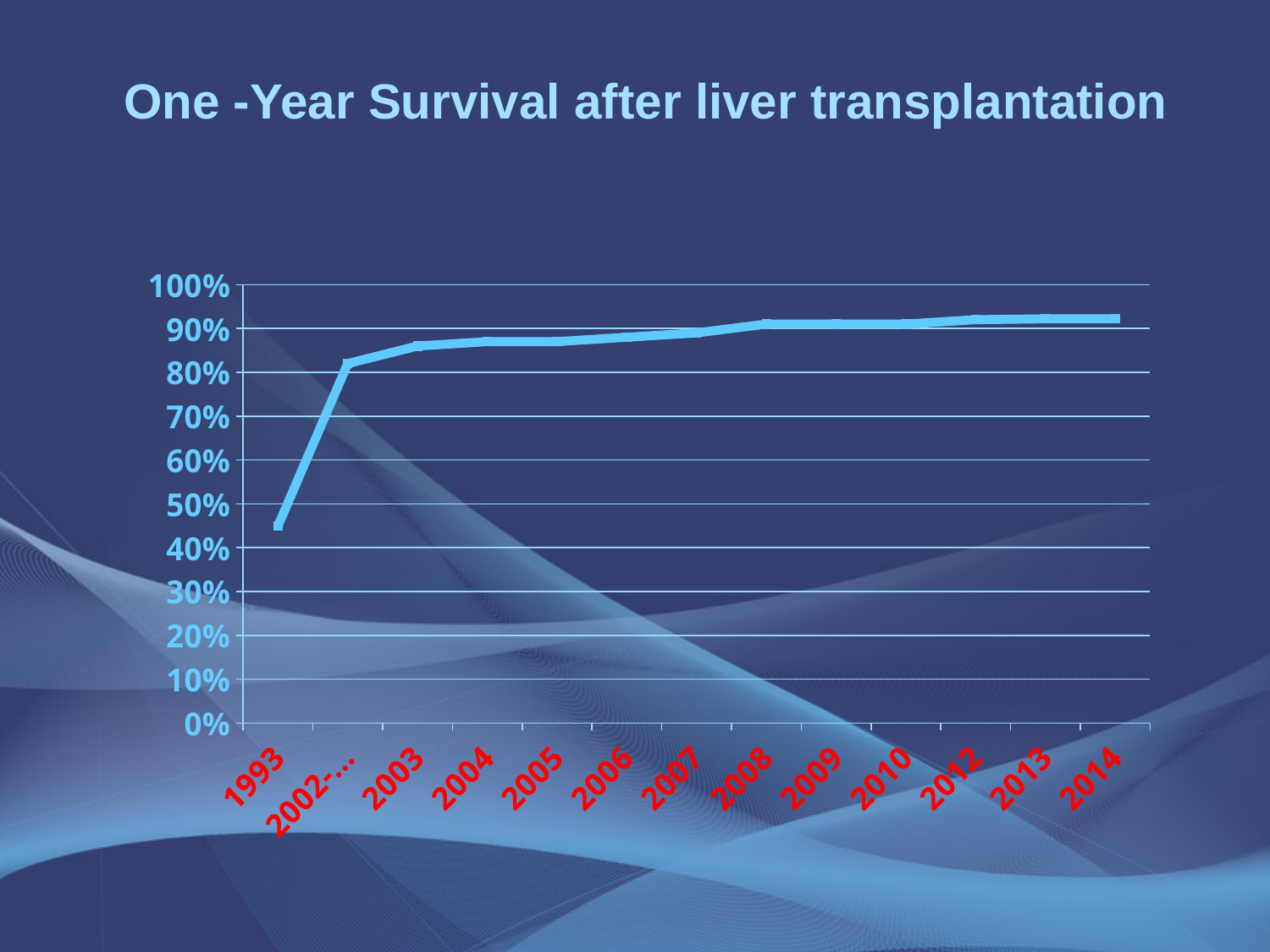
Is the value for 2003 greater or less than 80%? greater Is the value for 1993 greater or less than 50%? less Which is larger, the value for 1993 or the value for 2014? 2014 What is the title of the chart? One -Year Survival after liver transplantation What kind of chart is shown on the slide? line chart Which year has the lowest one-year survival value? 1993 Is the value for 2005 greater or less than 90%? less How many year categories are shown on the x axis? 13 Do the values generally rise or fall from 1993 to 2014? rise Which is larger, the value for 2002-... or the value for 2008? 2008